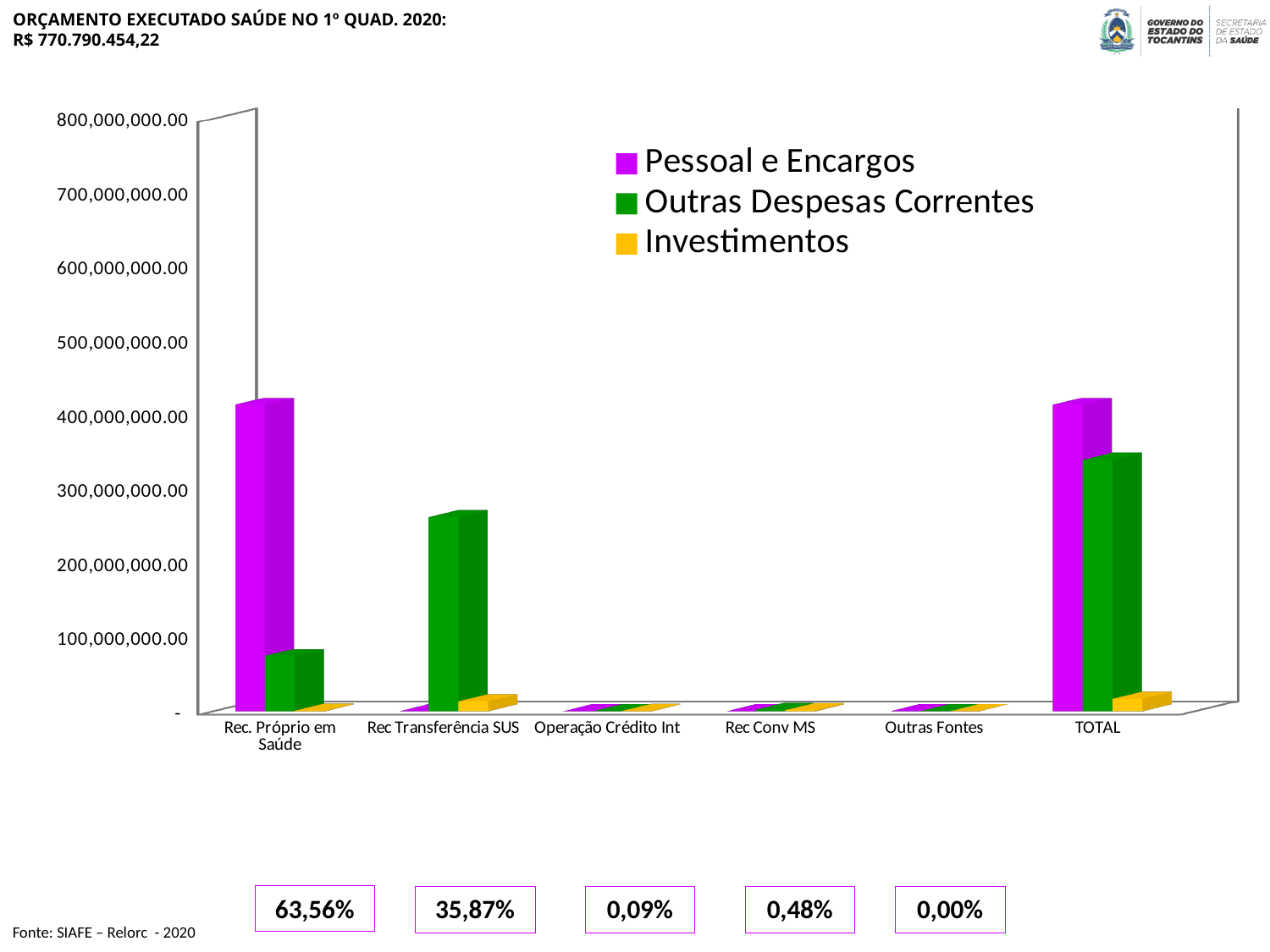
Which colour represents Investimentos in the chart legend? yellow Excluding TOTAL, which category has the highest value for Pessoal e Encargos? Rec. Próprio em Saúde Is the value of Outras Despesas Correntes for Rec Transferência SUS greater or less than 200,000,000.00? greater How many categories are shown along the x axis of the chart? 6 Is the value of Outras Despesas Correntes for Rec. Próprio em Saúde greater or less than 100,000,000.00? less How many series does the chart legend list? 3 Is the value of Pessoal e Encargos for TOTAL greater or less than 500,000,000.00? less For Rec. Próprio em Saúde, which is larger: Pessoal e Encargos or Outras Despesas Correntes? Pessoal e Encargos What kind of chart is shown on the slide? bar chart For Rec Transferência SUS, which is larger: Outras Despesas Correntes or Investimentos? Outras Despesas Correntes